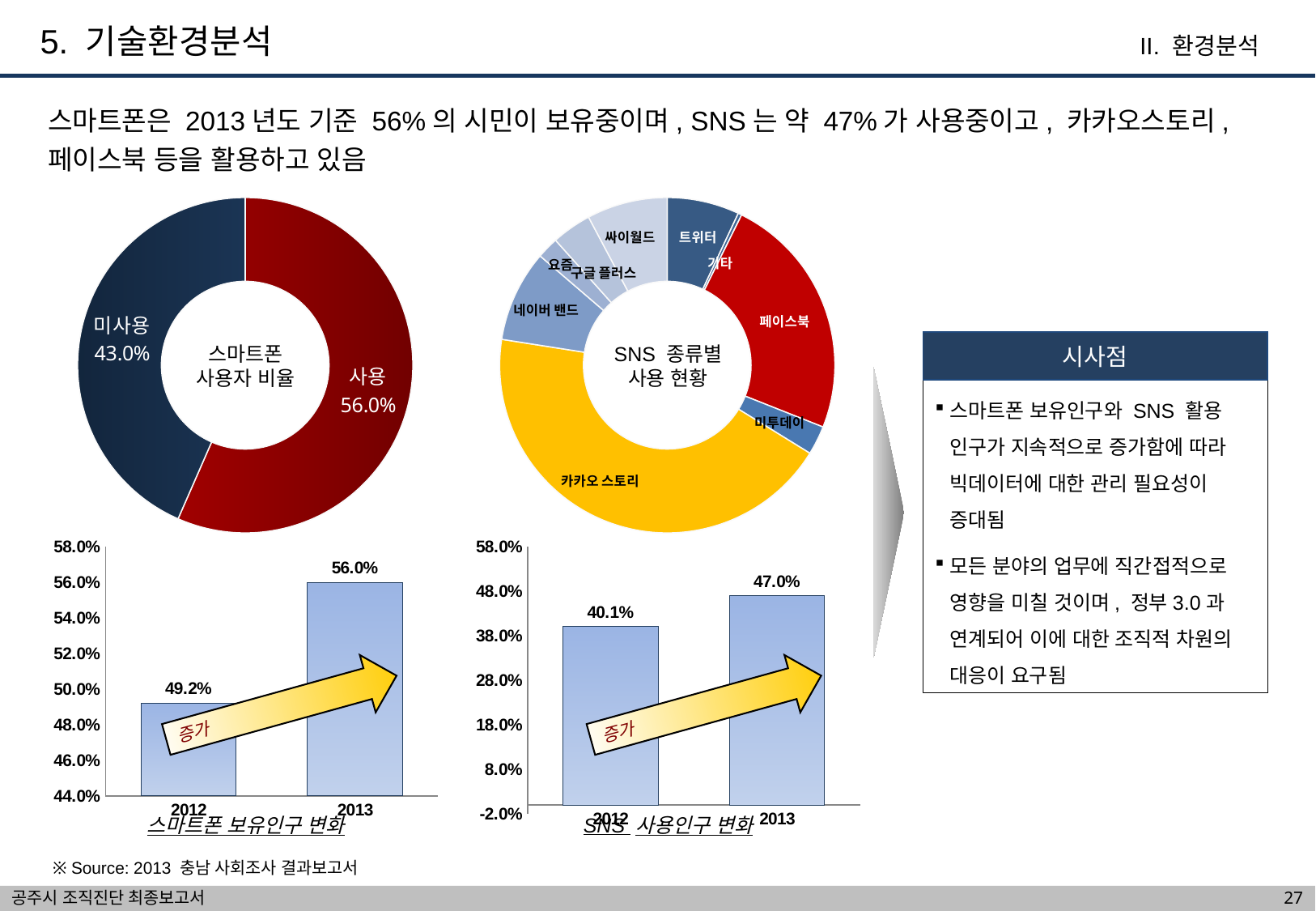
In the 스마트폰 보유인구 변화 bar chart, what is the value for 2013? 56.0% In the SNS 사용인구 변화 bar chart, what is the value for 2012? 40.1% In the 스마트폰 사용자 비율 donut chart, what is the value for 사용? 56.0% In the SNS 사용인구 변화 bar chart, do the values rise or fall from 2012 to 2013? rise In the SNS 종류별 사용 현황 donut chart, which SNS has the largest slice? 카카오 스토리 In the 스마트폰 사용자 비율 donut chart, which slice is larger, 사용 or 미사용? 사용 In the 스마트폰 사용자 비율 donut chart, what is the value for 미사용? 43.0% What kind of chart is the 스마트폰 보유인구 변화 chart at the bottom left? bar chart In the SNS 사용인구 변화 bar chart, what is the value for 2013? 47.0% In the SNS 종류별 사용 현황 donut chart, which slice is larger, 페이스북 or 트위터? 페이스북 In the 스마트폰 보유인구 변화 bar chart, what is the difference between the 2013 and 2012 values? 6.8% In the 스마트폰 보유인구 변화 bar chart, what is the value for 2012? 49.2%